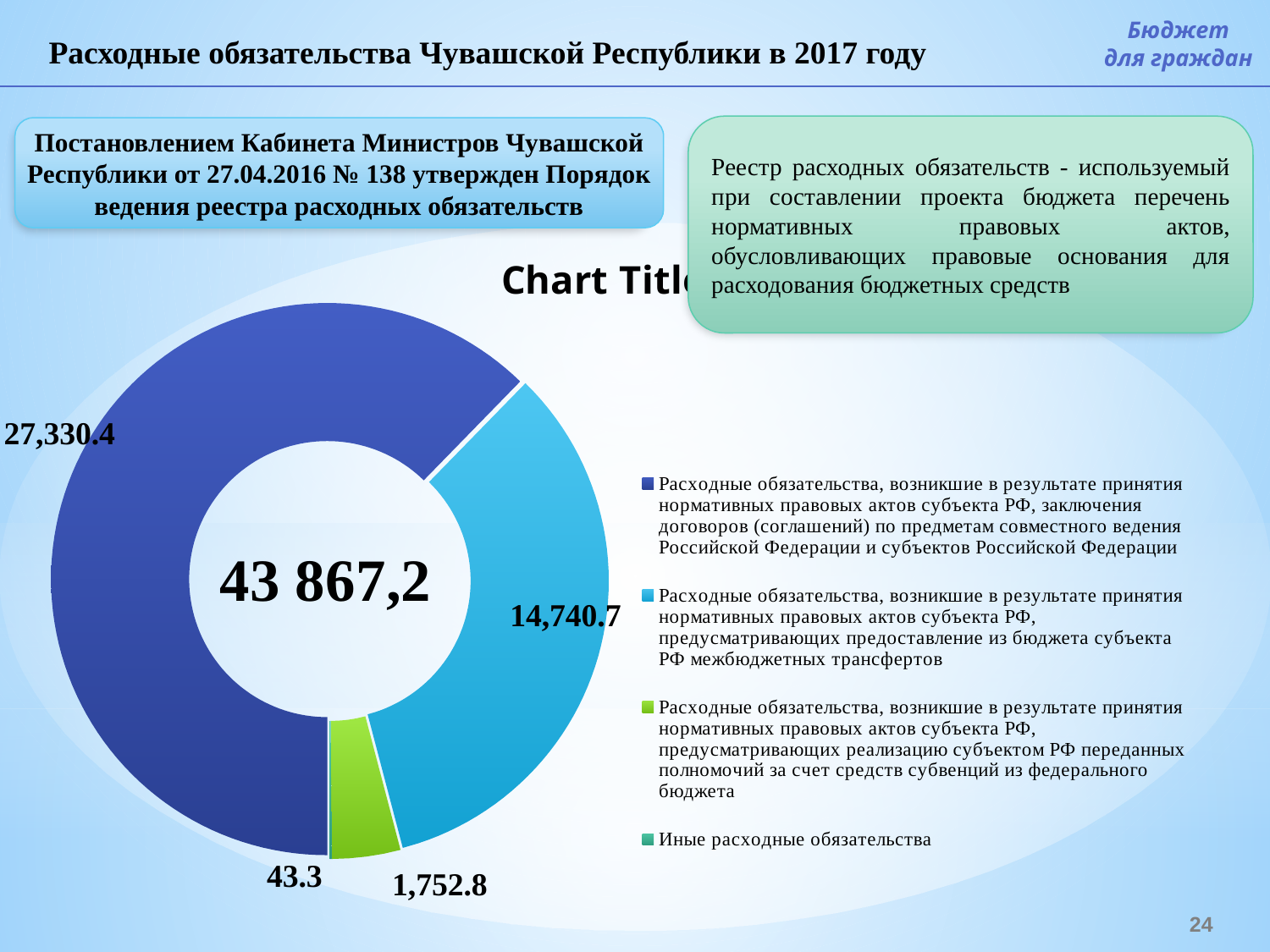
Which is larger: the slice for interbudgetary transfers or the slice for delegated powers funded by federal subventions? Interbudgetary transfers (14,740.7) What value is shown for the dark blue slice (expenditure obligations arising from acts on subjects of joint jurisdiction of the Russian Federation and its subjects)? 27,330.4 What value is shown for the slice labelled "Иные расходные обязательства" in the doughnut chart? 43.3 What value is shown for the green slice (expenditure obligations for delegated powers funded by federal subventions)? 1,752.8 What title is displayed above the doughnut chart? Chart Title How many slices does the doughnut chart have? 4 What type of chart is shown on the slide? Doughnut (pie) chart What total is printed in the centre of the doughnut chart? 43 867,2 Which category has the smallest slice in the doughnut chart? Иные расходные обязательства What is the difference between the dark blue slice (27,330.4) and the light blue slice (14,740.7)? 12,589.7 What value is shown for the light blue slice (expenditure obligations providing interbudgetary transfers from the subject's budget)? 14,740.7